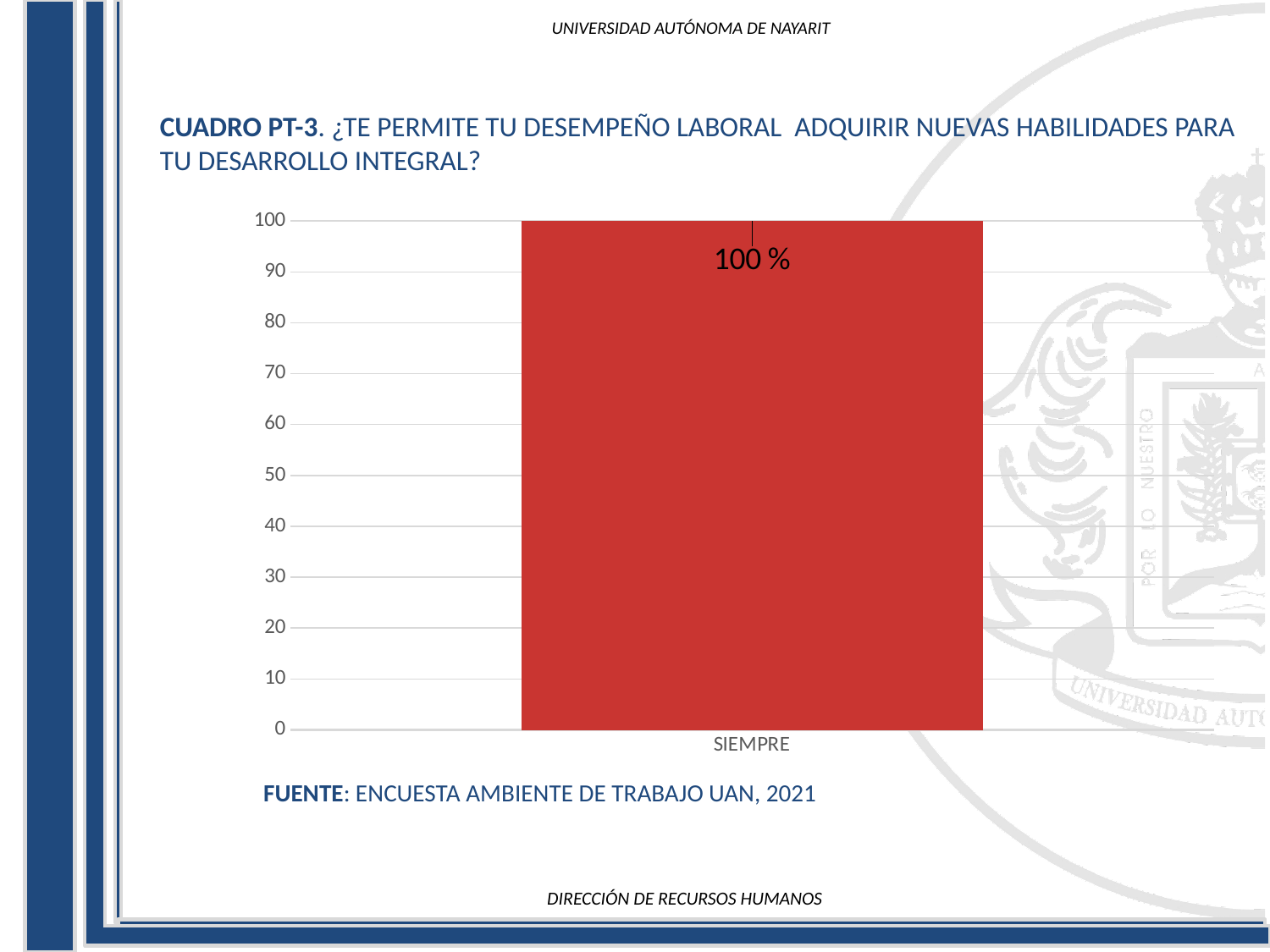
Which category has the highest value? SIEMPRE What is the label of the only category on the x axis? SIEMPRE What is the highest value shown on the y axis? 100 How many categories are plotted on the x axis? 1 Is the value for SIEMPRE greater or less than 50? greater What colour is the bar in the chart? red What kind of chart is shown on the slide? bar chart What is the value shown for SIEMPRE? 100 %